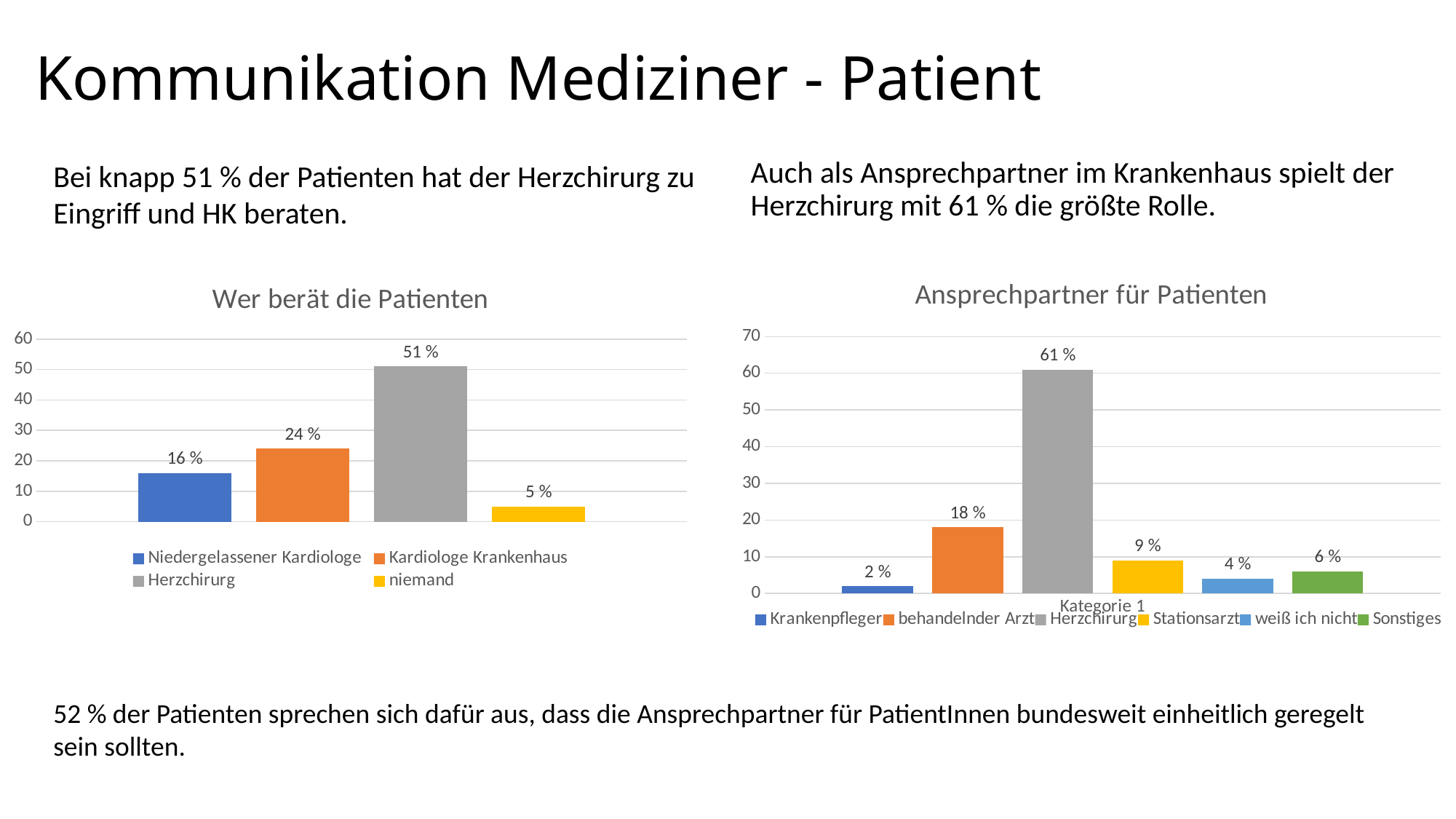
In the chart 'Ansprechpartner für Patienten', which is larger: Sonstiges or weiß ich nicht? Sonstiges In the chart 'Ansprechpartner für Patienten', which category has the highest value? Herzchirurg In the chart 'Wer berät die Patienten', what is the value for Herzchirurg? 51 % In the chart 'Wer berät die Patienten', how many series does the legend list? 4 In the chart 'Wer berät die Patienten', which category has the lowest value? niemand In the chart 'Ansprechpartner für Patienten', what is the value for Stationsarzt? 9 % In the chart 'Ansprechpartner für Patienten', how many series does the legend list? 6 In the chart 'Wer berät die Patienten', what is the difference between Herzchirurg and Niedergelassener Kardiologe? 35 % In the chart 'Ansprechpartner für Patienten', what is the value for behandelnder Arzt? 18 % In the chart 'Wer berät die Patienten', what is the value for Kardiologe Krankenhaus? 24 % What kind of chart is 'Ansprechpartner für Patienten'? bar chart In the chart 'Ansprechpartner für Patienten', which category has the lowest value? Krankenpfleger